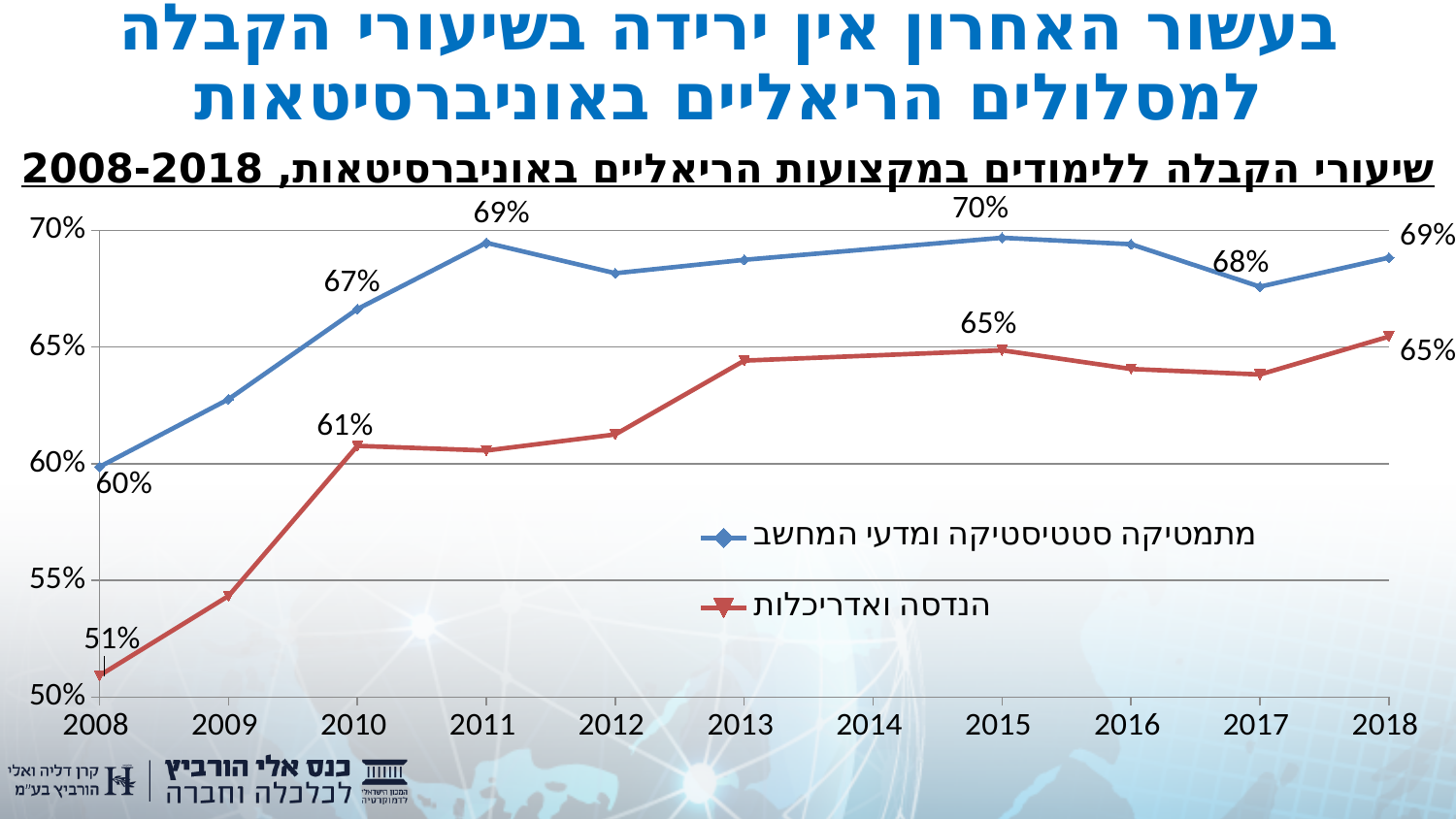
How many series does the legend list? 2 What is the value for מתמטיקה סטטיסטיקה ומדעי המחשב in 2015? 70% Does the value for הנדסה ואדריכלות rise or fall from 2008 to 2018? rise What is the difference between the two series in 2008? 9 percentage points Which series has the higher value in 2018? מתמטיקה סטטיסטיקה ומדעי המחשב How many years are shown on the x axis? 11 What is the value for הנדסה ואדריכלות in 2018? 65% What is the value for הנדסה ואדריכלות in 2008? 51% What is the value for מתמטיקה סטטיסטיקה ומדעי המחשב in 2008? 60% Is the value for הנדסה ואדריכלות in 2009 greater or less than 55%? less What is the value for הנדסה ואדריכלות in 2010? 61% What type of chart is shown on the slide? line chart